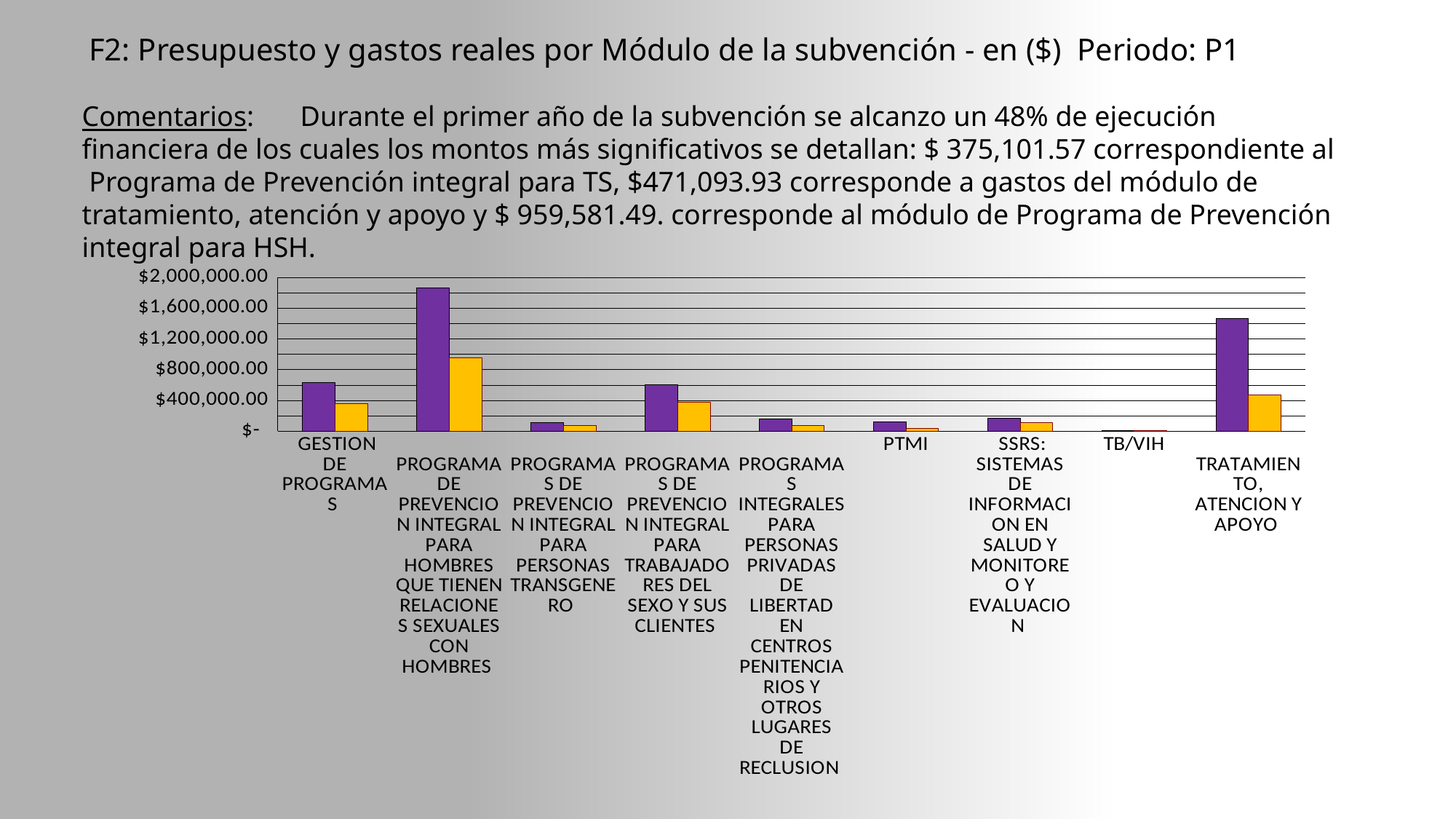
Is the purple bar for PROGRAMAS DE PREVENCION INTEGRAL PARA PERSONAS TRANSGENERO greater or less than $400,000.00? less Is the orange bar for PROGRAMA DE PREVENCION INTEGRAL PARA HOMBRES QUE TIENEN RELACIONES SEXUALES CON HOMBRES greater or less than $800,000.00? greater Which category has the tallest orange bar? PROGRAMA DE PREVENCION INTEGRAL PARA HOMBRES QUE TIENEN RELACIONES SEXUALES CON HOMBRES Is the purple bar for GESTION DE PROGRAMAS greater or less than $800,000.00? less Which is larger for TRATAMIENTO, ATENCION Y APOYO: the purple bar or the orange bar? the purple bar Which category has the tallest purple bar? PROGRAMA DE PREVENCION INTEGRAL PARA HOMBRES QUE TIENEN RELACIONES SEXUALES CON HOMBRES What kind of chart is shown on the slide? bar chart Which category has the lowest bars in the chart? TB/VIH How many bars are plotted for each category in the chart? 2 How many categories are shown along the x axis of the chart? 9